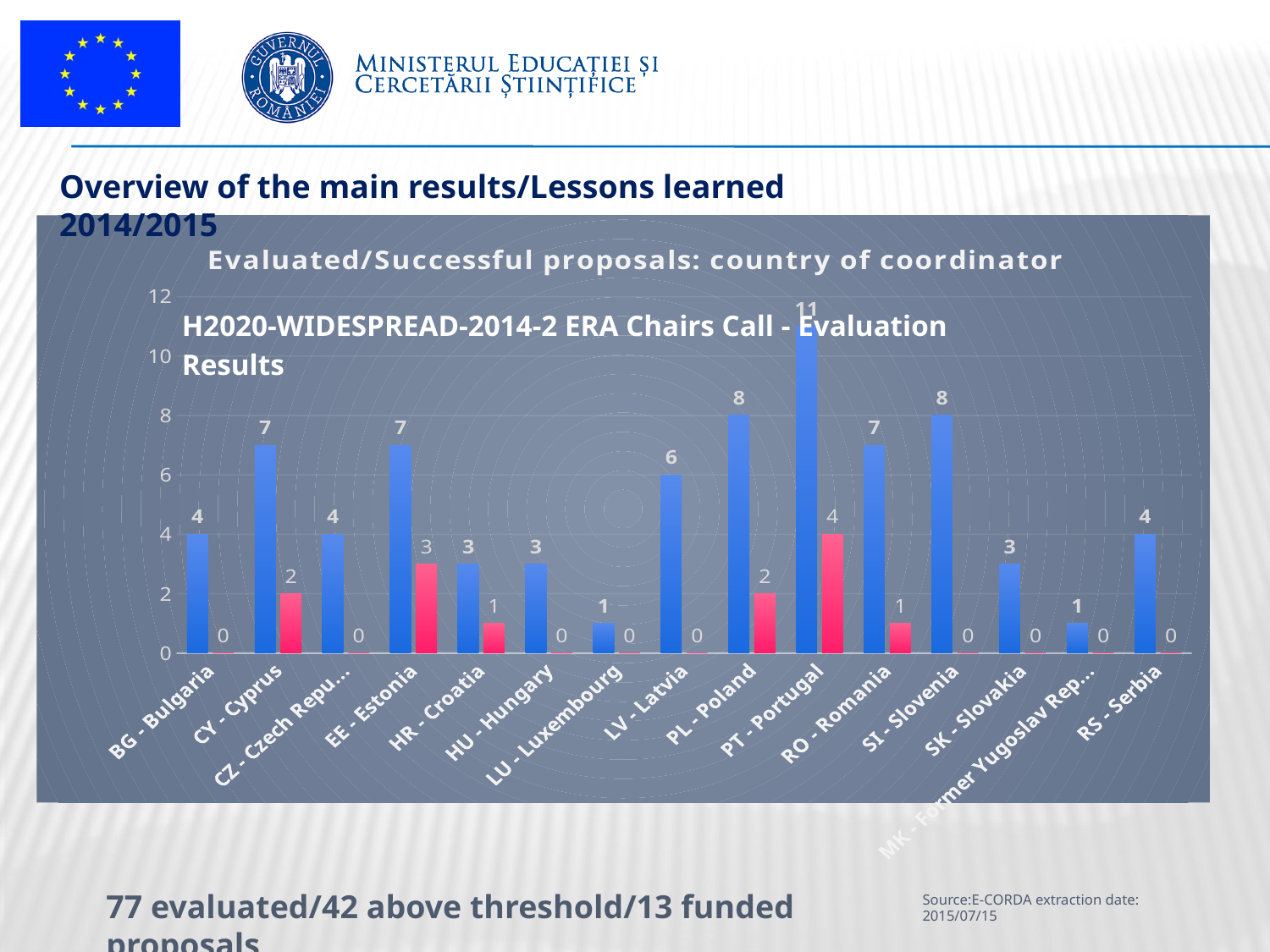
What is the value of the blue bar for LV - Latvia? 6 What is the value of the blue bar for PT - Portugal? 11 Which is larger, the blue bar for SI - Slovenia or the blue bar for RO - Romania? SI - Slovenia What is the difference between the blue bar and the pink bar for PL - Poland? 6 Which country has the highest blue bar? PT - Portugal What is the value of the blue bar for LU - Luxembourg? 1 What kind of chart is shown on the slide? bar chart How many countries are shown on the x axis of the chart? 15 What is the value of the pink bar for HR - Croatia? 1 Which country has the highest pink bar? PT - Portugal What is the title of the chart? Evaluated/Successful proposals: country of coordinator What is the value of the pink bar for EE - Estonia? 3